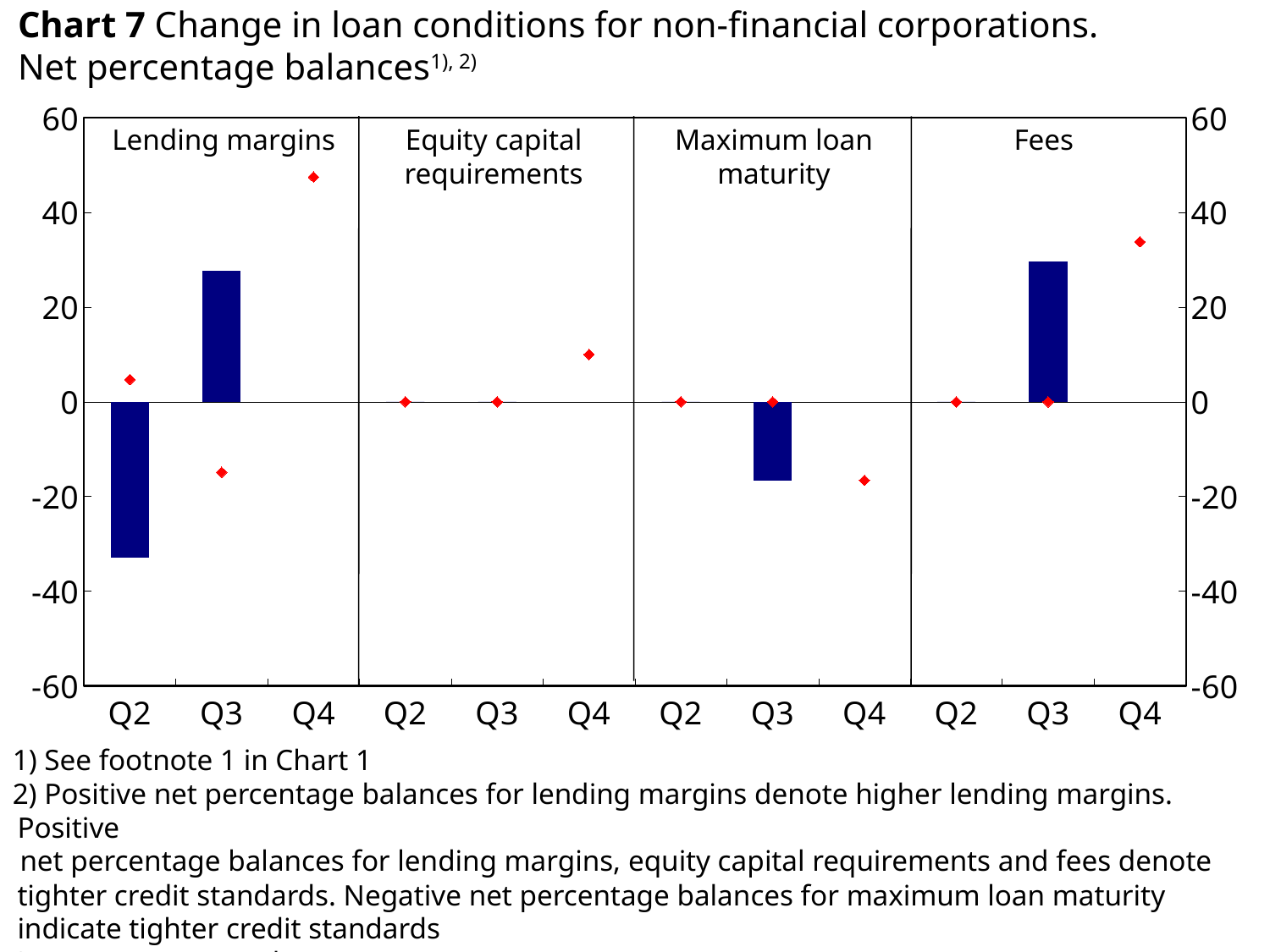
In the Equity capital requirements panel, do the red markers rise or fall from Q2 to Q4? rise What kind of chart is shown on the slide? combination chart (bars with red markers) What is the title of the fourth (rightmost) panel of the chart? Fees In the Lending margins panel, is the bar for Q2 greater or less than -20? less In the Maximum loan maturity panel, is the bar for Q3 greater or less than 0? less In the Equity capital requirements panel, what is the value of the red marker for Q2? 0 In the Lending margins panel, is the red marker for Q4 greater or less than 40? greater Which is larger: the Q3 bar in the Lending margins panel or the Q3 bar in the Maximum loan maturity panel? Lending margins Q3 How many quarters are shown on the x axis of each panel? 3 How many panels (loan condition categories) does the chart have? 4